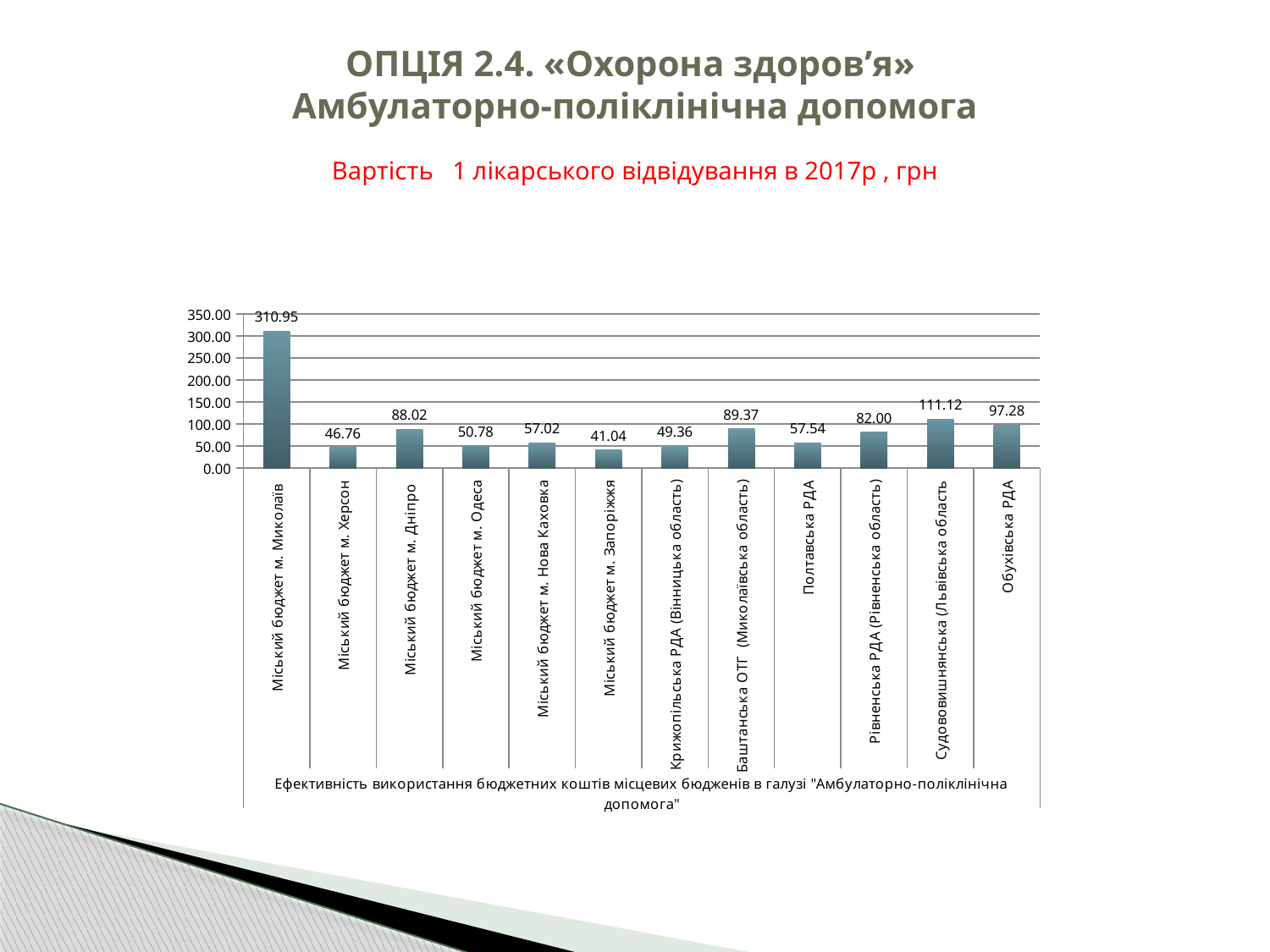
What is the value for Баштанська ОТГ (Миколаївська область)? 89.37 How many categories are shown on the chart? 12 What is the value for Міський бюджет м. Запоріжжя? 41.04 Which category has the highest value? Міський бюджет м. Миколаїв What is the value for Міський бюджет м. Миколаїв? 310.95 Which category has the lowest value? Міський бюджет м. Запоріжжя What is the value for Судововишнянська (Львівська область)? 111.12 What is the difference between the values for Обухівська РДА and Рівненська РДА (Рівненська область)? 15.28 What is the red subtitle above the chart? Вартість 1 лікарського відвідування в 2017р , грн Is the value for Міський бюджет м. Миколаїв greater or less than 300.00? greater Which is larger: the value for Міський бюджет м. Дніпро or the value for Міський бюджет м. Одеса? Міський бюджет м. Дніпро What kind of chart is shown on the slide? bar chart